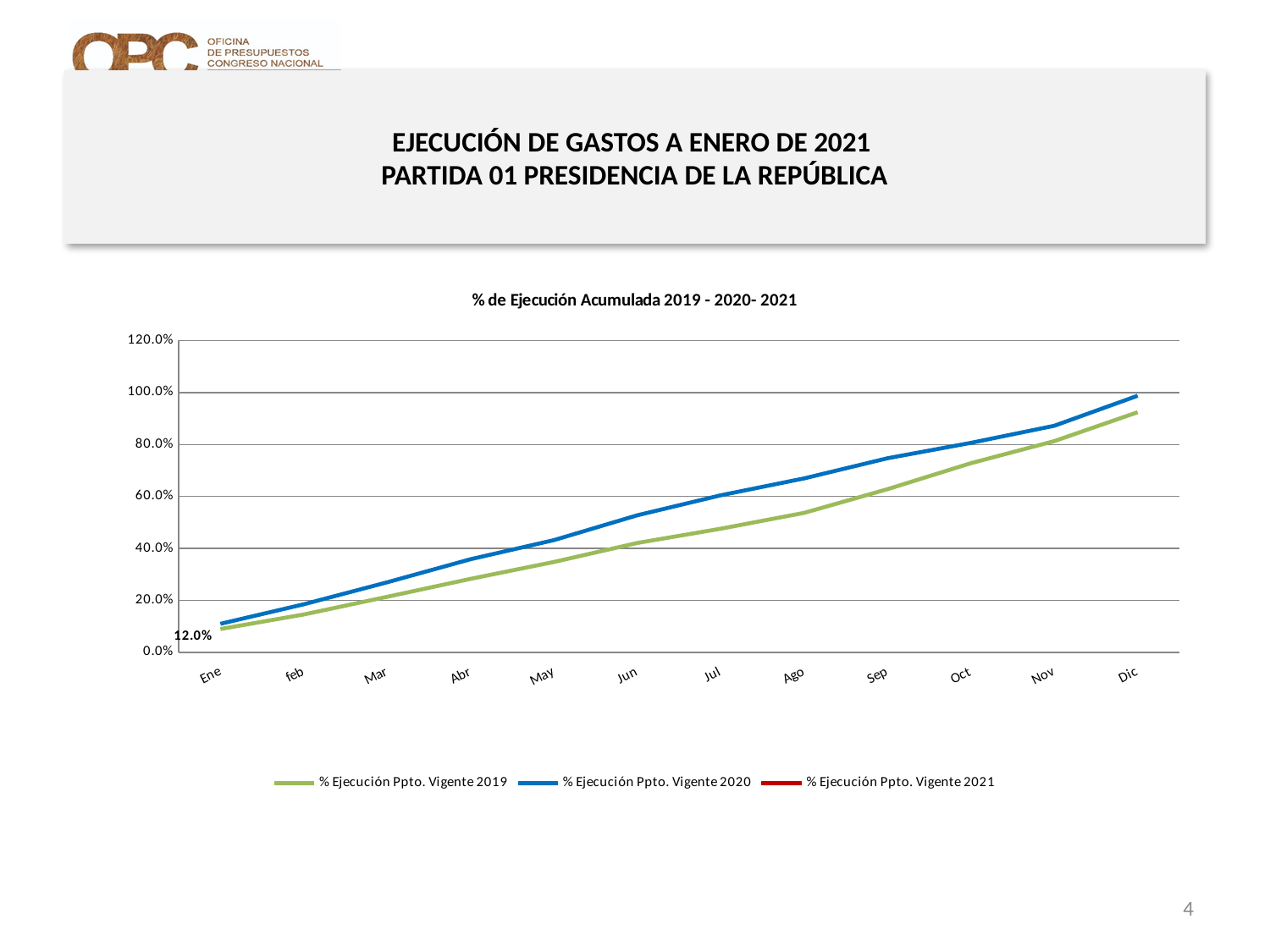
What data label is printed on the chart near Ene? 12.0% Is the value for % Ejecución Ppto. Vigente 2020 in Dic greater or less than 80.0%? greater What kind of chart is shown on the slide? line chart Is the value for % Ejecución Ppto. Vigente 2019 in Jun greater or less than 60.0%? less How many months are shown along the x axis? 12 Is the value for % Ejecución Ppto. Vigente 2019 in Oct greater or less than 60.0%? greater How many series does the legend list? 3 What is the title of the chart? % de Ejecución Acumulada 2019 - 2020- 2021 In which month is % Ejecución Ppto. Vigente 2019 at its lowest value? Ene Do the values for % Ejecución Ppto. Vigente 2020 rise or fall from Ene to Dic? rise In Ago, which series has the higher value, % Ejecución Ppto. Vigente 2019 or % Ejecución Ppto. Vigente 2020? % Ejecución Ppto. Vigente 2020 In which month does % Ejecución Ppto. Vigente 2020 reach its highest value? Dic